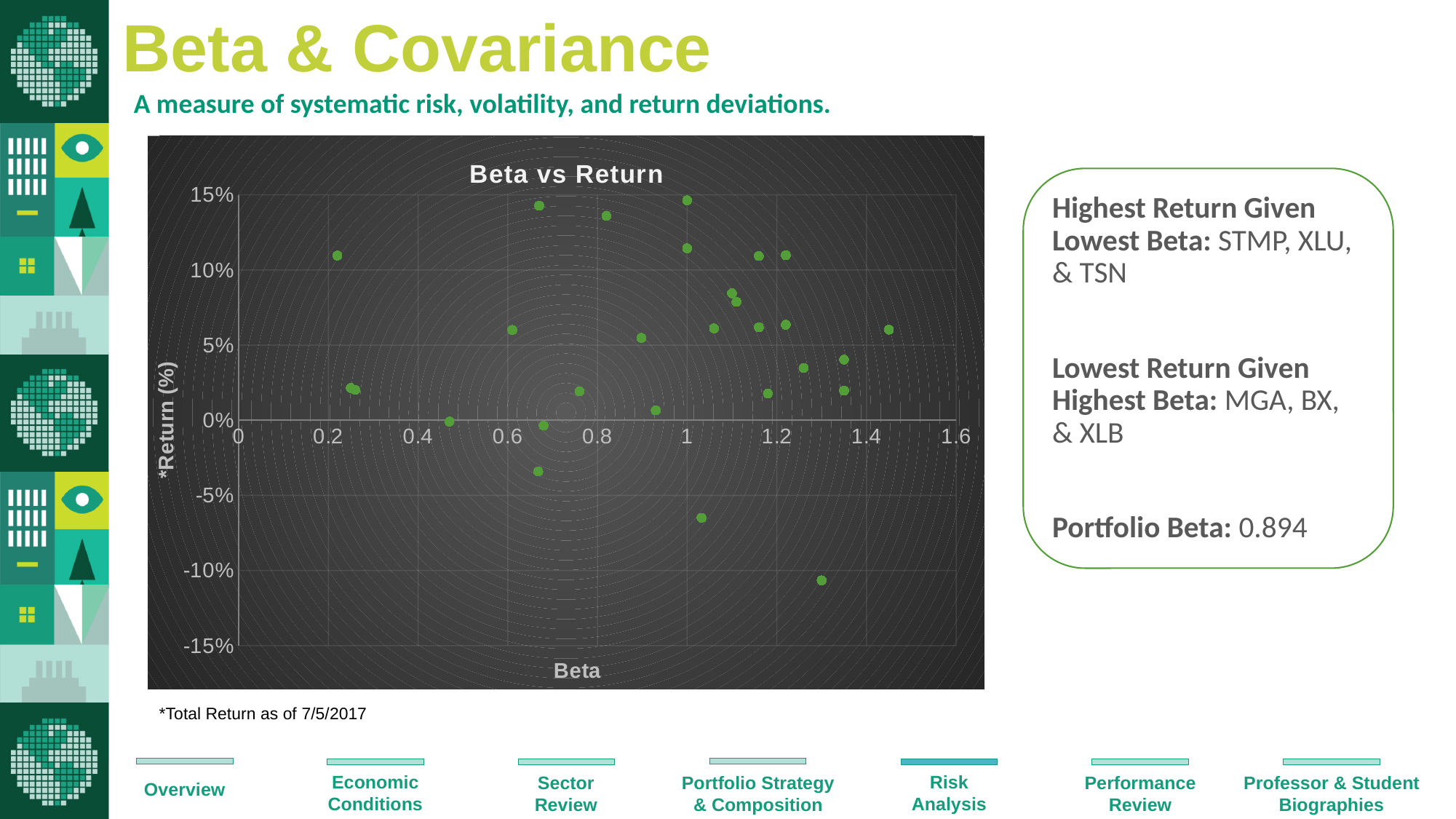
Is the return of the point with the highest beta greater or less than 10%? less Is the return of the point with the lowest beta greater or less than 5%? greater What is the label on the vertical axis of the chart? *Return (%) What is the title of the chart? Beta vs Return Is the beta of the point with the lowest return greater or less than 1.2? greater Which has the higher return: the point with the lowest beta or the point with the highest beta? the point with the lowest beta What kind of chart is shown on the slide? scatter chart